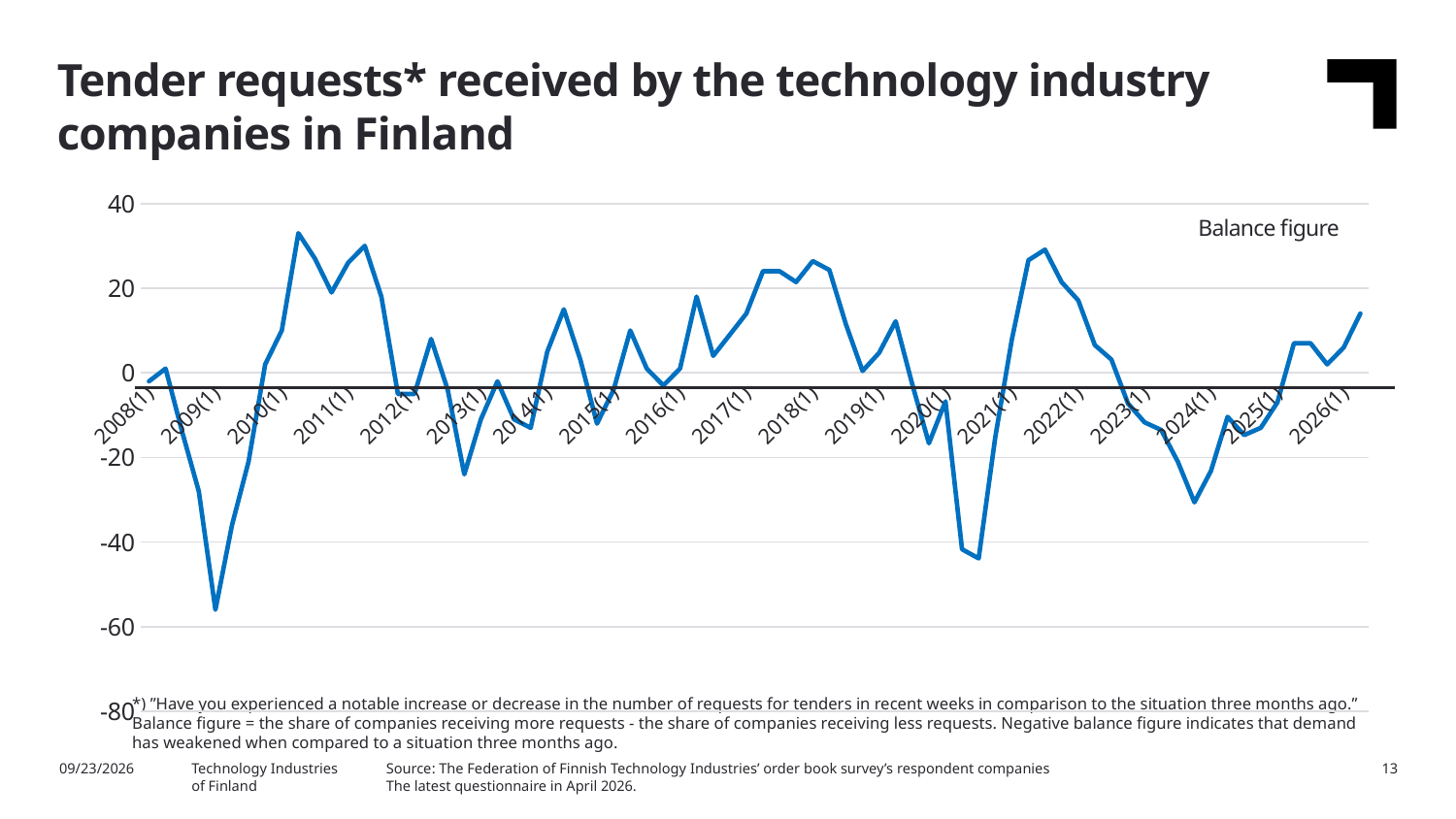
In which year does the balance figure reach its lowest point? 2009 What is the name of the series plotted in the chart? Balance figure Is the balance figure at 2024(1) greater or less than -20? less Is the balance figure at 2022(1) greater or less than 20? less What kind of chart is shown on the slide? line chart Is the balance figure at 2026(1) greater or less than 0? greater Which is larger, the balance figure at 2022(1) or at 2024(1)? 2022(1) How many year labels are shown on the x axis of the chart? 19 What is the title of the chart on the slide? Tender requests* received by the technology industry companies in Finland Does the balance figure rise or fall between 2022(1) and 2024(1)? fall Does the balance figure rise or fall between 2008(1) and 2009(1)? fall